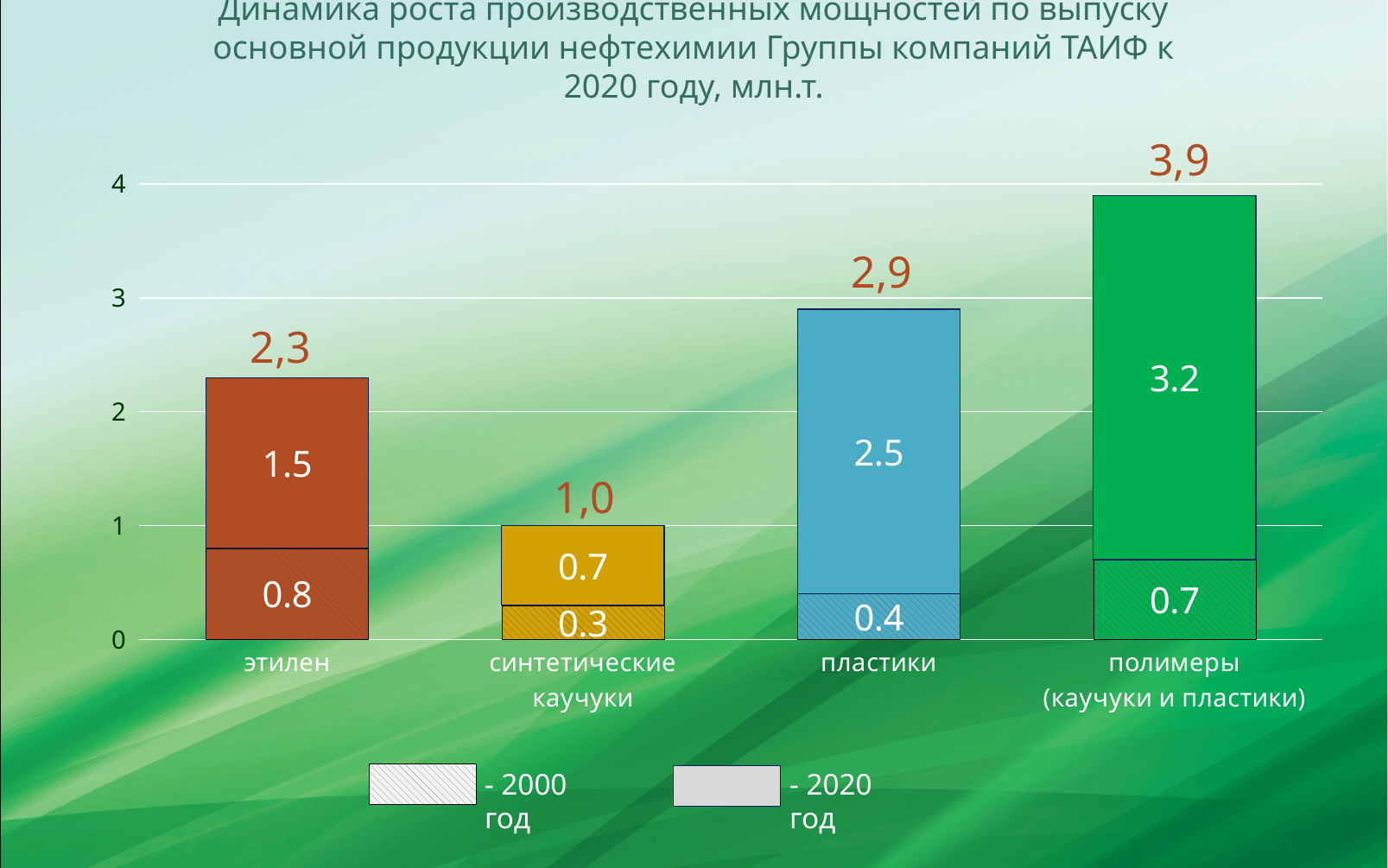
Which legend entry is shown with a hatched pattern? - 2000 год Which category has the highest total bar? полимеры (каучуки и пластики) What is the 2020 год value for синтетические каучуки? 0.7 Which is larger: the 2000 год value for полимеры (каучуки и пластики) or the 2000 год value for пластики? полимеры (каучуки и пластики) Which category has the lowest total bar? синтетические каучуки What is the difference between the 2020 год value and the 2000 год value for пластики? 2.1 What type of chart is shown on the slide? stacked bar chart What is the total labelled above the bar for полимеры (каучуки и пластики)? 3,9 What is the 2020 год value for пластики? 2.5 How many categories are shown on the x axis? 4 What is the 2000 год value for этилен? 0.8 How many series does the legend list? 2